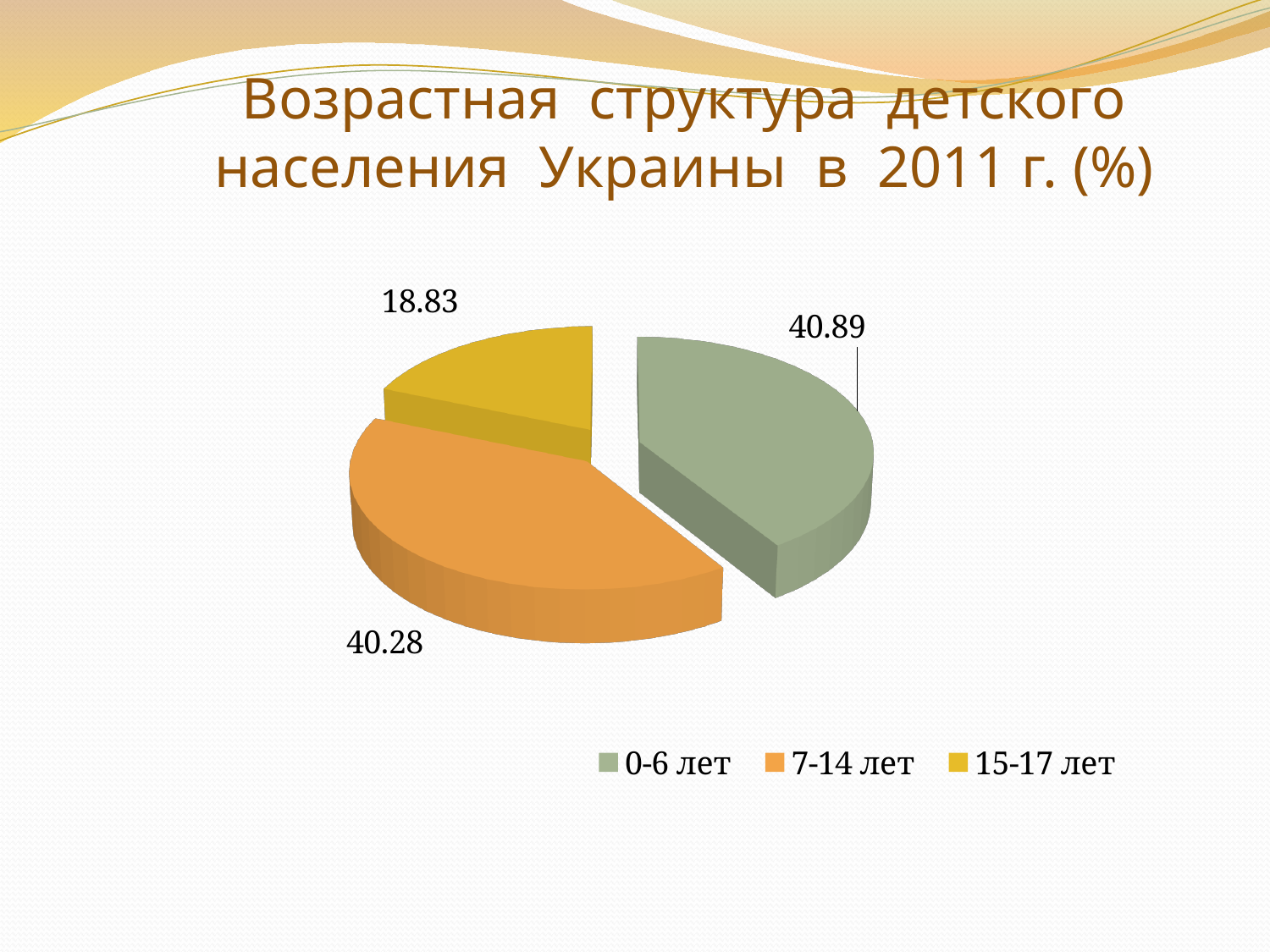
How many entries does the legend list? 3 What is the difference between the values for 0-6 лет and 15-17 лет? 22.06 What type of chart is shown on the slide? Pie chart What colour is the 7-14 лет slice? Orange Which is larger, the value for 7-14 лет or the value for 15-17 лет? 7-14 лет What is the value for the 0-6 лет slice? 40.89 What is the difference between the values for 7-14 лет and 15-17 лет? 21.45 What is the value for the 7-14 лет slice? 40.28 Which age group has the largest share of the pie? 0-6 лет What is the value for the 15-17 лет slice? 18.83 Which age group has the smallest share of the pie? 15-17 лет How many slices does the pie chart have? 3